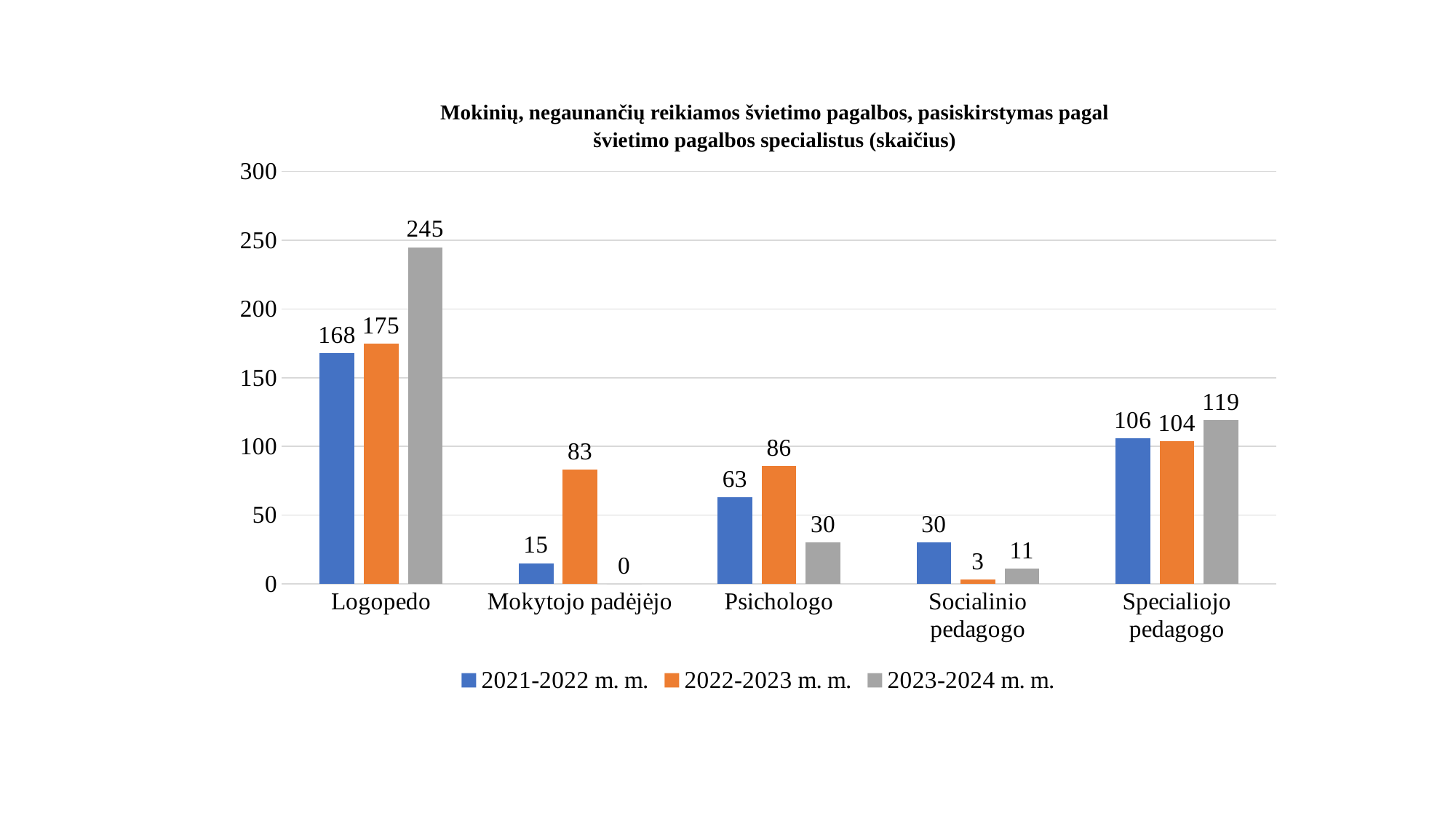
Which is larger for Psichologo: the 2021-2022 m. m. value or the 2022-2023 m. m. value? 2022-2023 m. m. What is the difference between the 2023-2024 m. m. and 2021-2022 m. m. values for Logopedo? 77 What is the value for Mokytojo padėjėjo in the 2022-2023 m. m. series? 83 Is the value for Specialiojo pedagogo in 2023-2024 m. m. greater or less than 100? greater Which category has the highest value in the 2021-2022 m. m. series? Logopedo Which category has the lowest value in the 2023-2024 m. m. series? Mokytojo padėjėjo How many categories are shown on the x axis? 5 What is the value for Logopedo in the 2023-2024 m. m. series? 245 What is the value for Socialinio pedagogo in the 2022-2023 m. m. series? 3 Which colour represents the 2022-2023 m. m. series? Orange What kind of chart is shown on the slide? Bar chart How many series does the legend list? 3